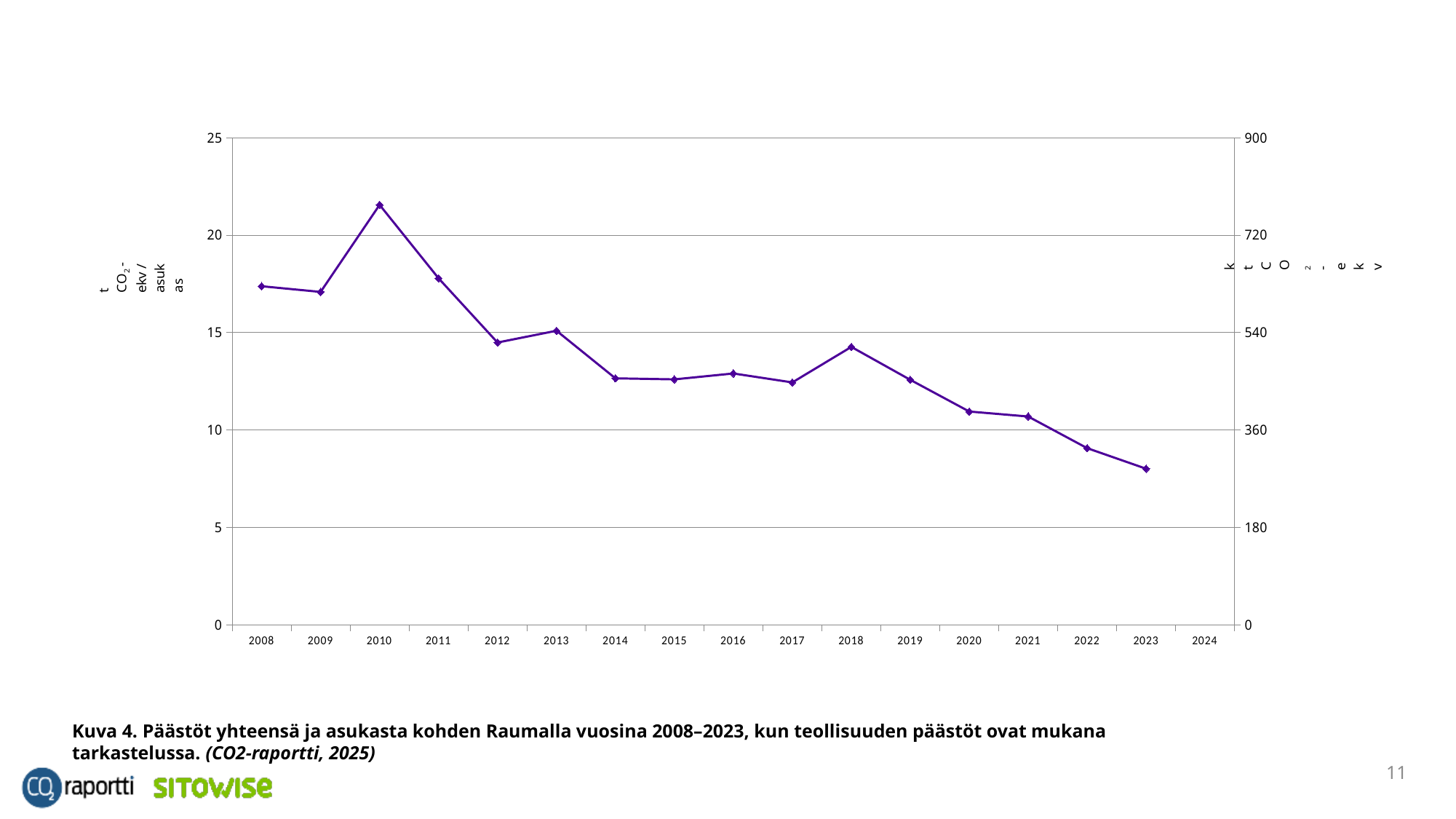
Which year has the highest plotted value? 2010 What kind of chart is shown on the slide? line chart Is the value for 2022 on the left axis greater or less than 10? less Is the value for 2010 on the left axis greater or less than 20? greater What is the maximum value shown on the right-hand vertical axis? 900 Is the value for 2023 on the left axis greater or less than 10? less Which year has the larger value, 2010 or 2023? 2010 Which year has the lowest plotted value? 2023 Overall, do the plotted values rise or fall from 2008 to 2023? fall Which year has the larger value, 2017 or 2018? 2018 How many years have a plotted data point on the line? 16